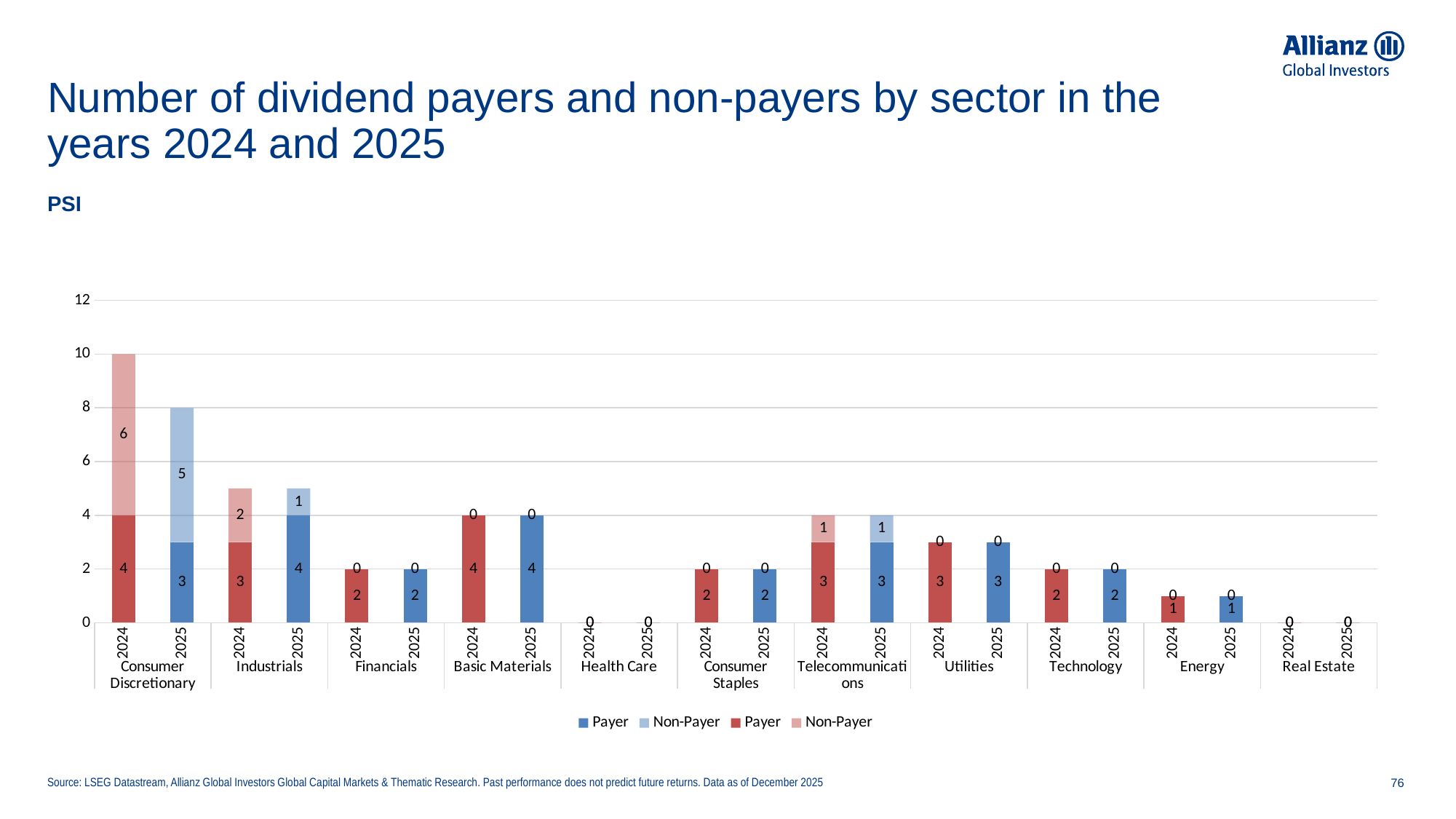
Which is larger: the number of payers in Basic Materials in 2024 or in Energy in 2024? Basic Materials in 2024 How many non-payers did Telecommunications have in 2024? 1 How many dividend payers did Industrials have in 2025? 4 How many dividend payers did Consumer Discretionary have in 2024? 4 What is the total height of the 2025 stacked bar for Industrials? 5 What is the difference between the number of non-payers in Consumer Discretionary in 2024 and in 2025? 1 What is the total height of the 2024 stacked bar for Consumer Discretionary? 10 How many non-payers did Consumer Discretionary have in 2025? 5 What kind of chart is shown on the slide? Stacked bar chart How many entries does the legend list? 4 Which sector has the tallest stacked bar in 2024? Consumer Discretionary How many sectors are shown on the x axis? 11